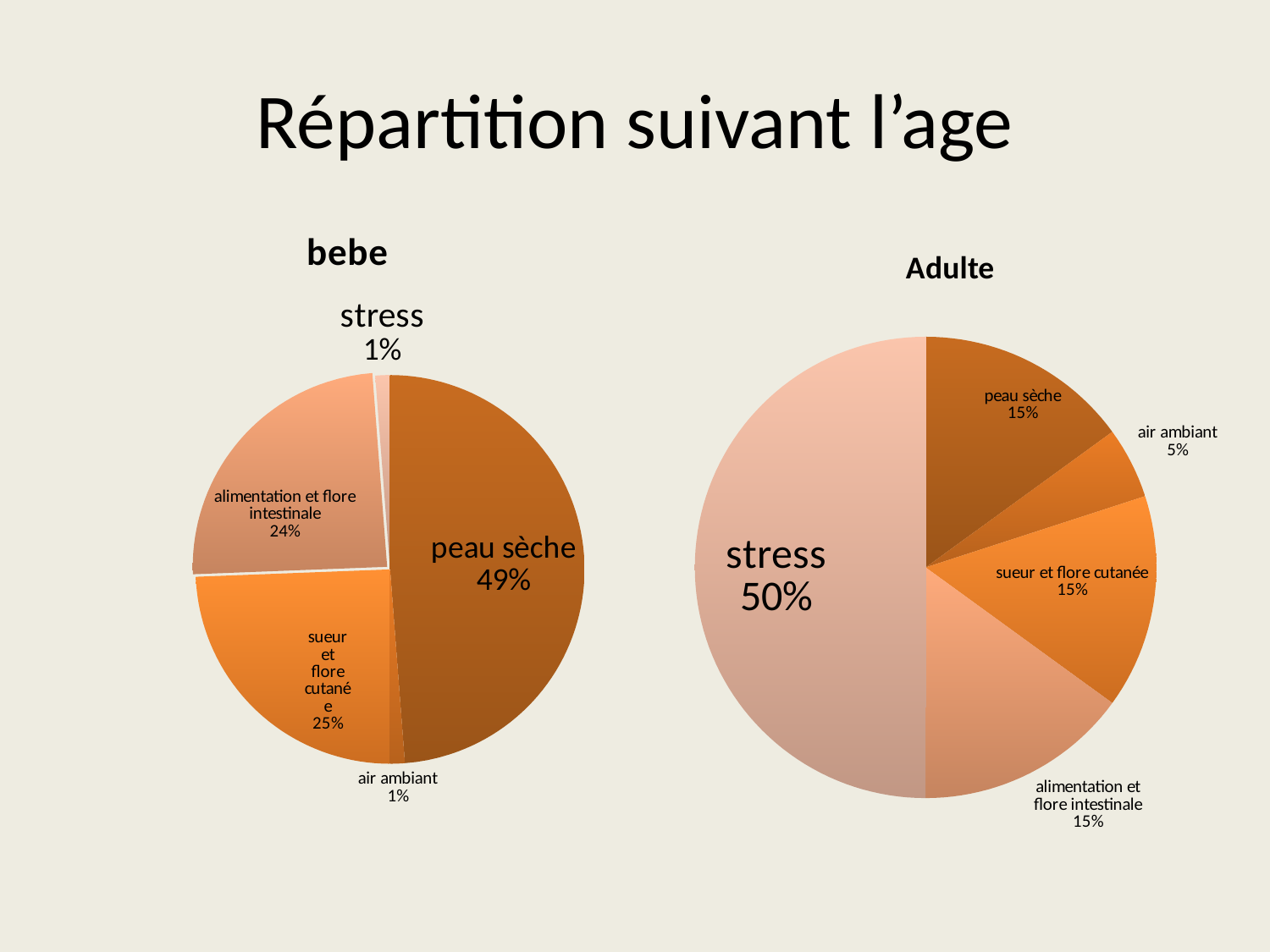
In the "bebe" chart, which category has the largest slice? peau sèche What is the difference between the "stress" share in the "Adulte" chart and the "stress" share in the "bebe" chart? 49% In the "Adulte" chart, what share does "stress" have? 50% How many slices does the "Adulte" chart have? 5 In the "bebe" chart, what share does "alimentation et flore intestinale" have? 24% In the "Adulte" chart, what share does "air ambiant" have? 5% What is the title of the chart on the right? Adulte In the "Adulte" chart, what is the combined share of "peau sèche" and "sueur et flore cutanée"? 30% In the "Adulte" chart, which category has the smallest slice? air ambiant In the "bebe" chart, which is larger: "sueur et flore cutanée" or "alimentation et flore intestinale"? sueur et flore cutanée In the "bebe" chart, what share does "peau sèche" have? 49% What kind of chart is the "bebe" chart? pie chart